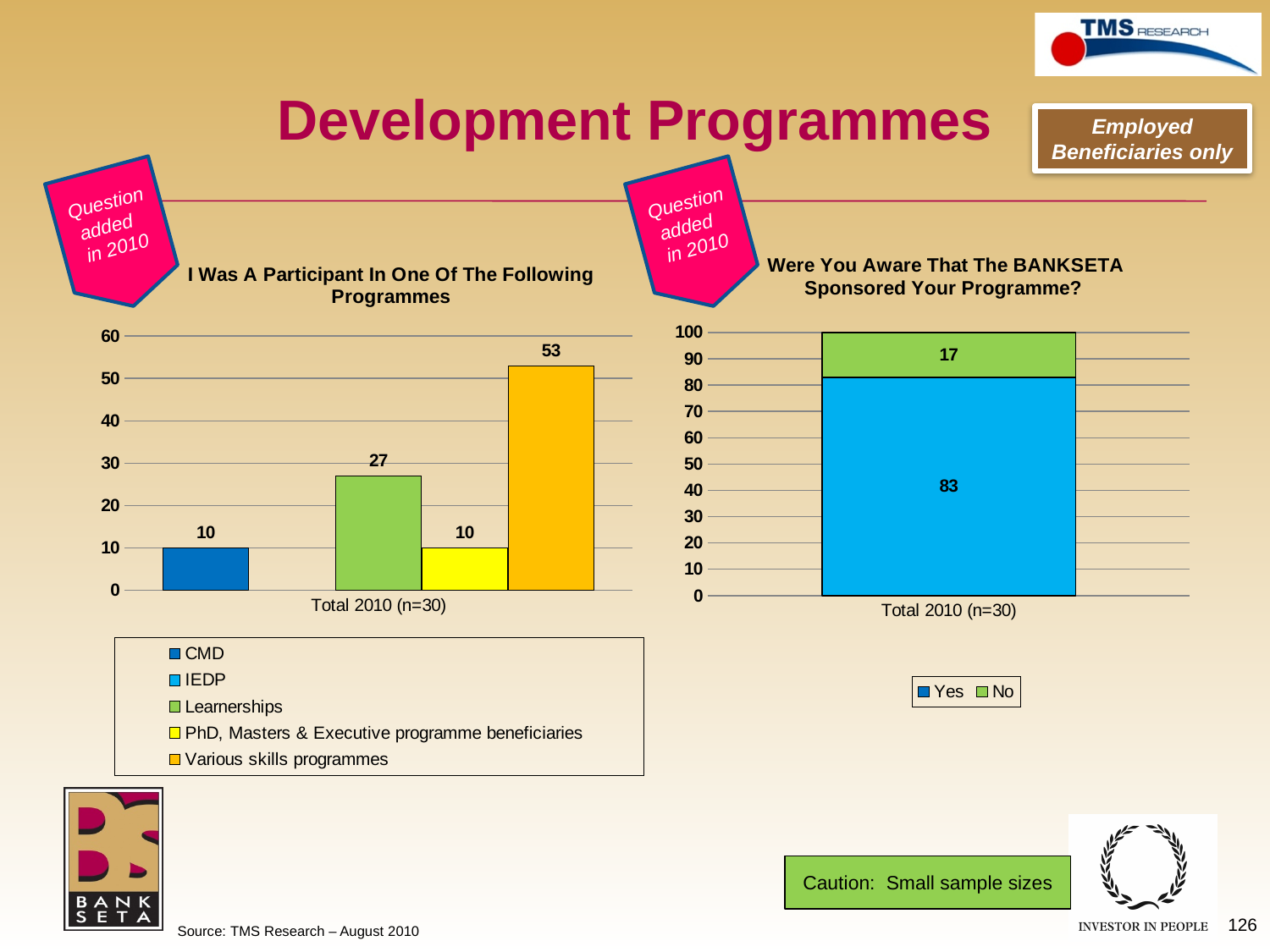
In the chart 'I Was A Participant In One Of The Following Programmes', what is the difference between Various skills programmes and Learnerships? 26 In the chart 'I Was A Participant In One Of The Following Programmes', which programme has the highest value? Various skills programmes What kind of chart is 'Were You Aware That The BANKSETA Sponsored Your Programme?'? Stacked bar chart In the chart 'Were You Aware That The BANKSETA Sponsored Your Programme?', what is the value for No? 17 In the chart 'I Was A Participant In One Of The Following Programmes', which is larger: Learnerships or CMD? Learnerships In the chart 'I Was A Participant In One Of The Following Programmes', what is the value for CMD? 10 How many series does the legend of the chart 'I Was A Participant In One Of The Following Programmes' list? 5 In the chart 'I Was A Participant In One Of The Following Programmes', what is the value for Learnerships? 27 What is the x-axis category label shown on the chart 'Were You Aware That The BANKSETA Sponsored Your Programme?'? Total 2010 (n=30) In the chart 'I Was A Participant In One Of The Following Programmes', what is the value for Various skills programmes? 53 In the chart 'Were You Aware That The BANKSETA Sponsored Your Programme?', what is the total of the stacked bar for Total 2010 (n=30)? 100 In the chart 'Were You Aware That The BANKSETA Sponsored Your Programme?', what is the value for Yes? 83